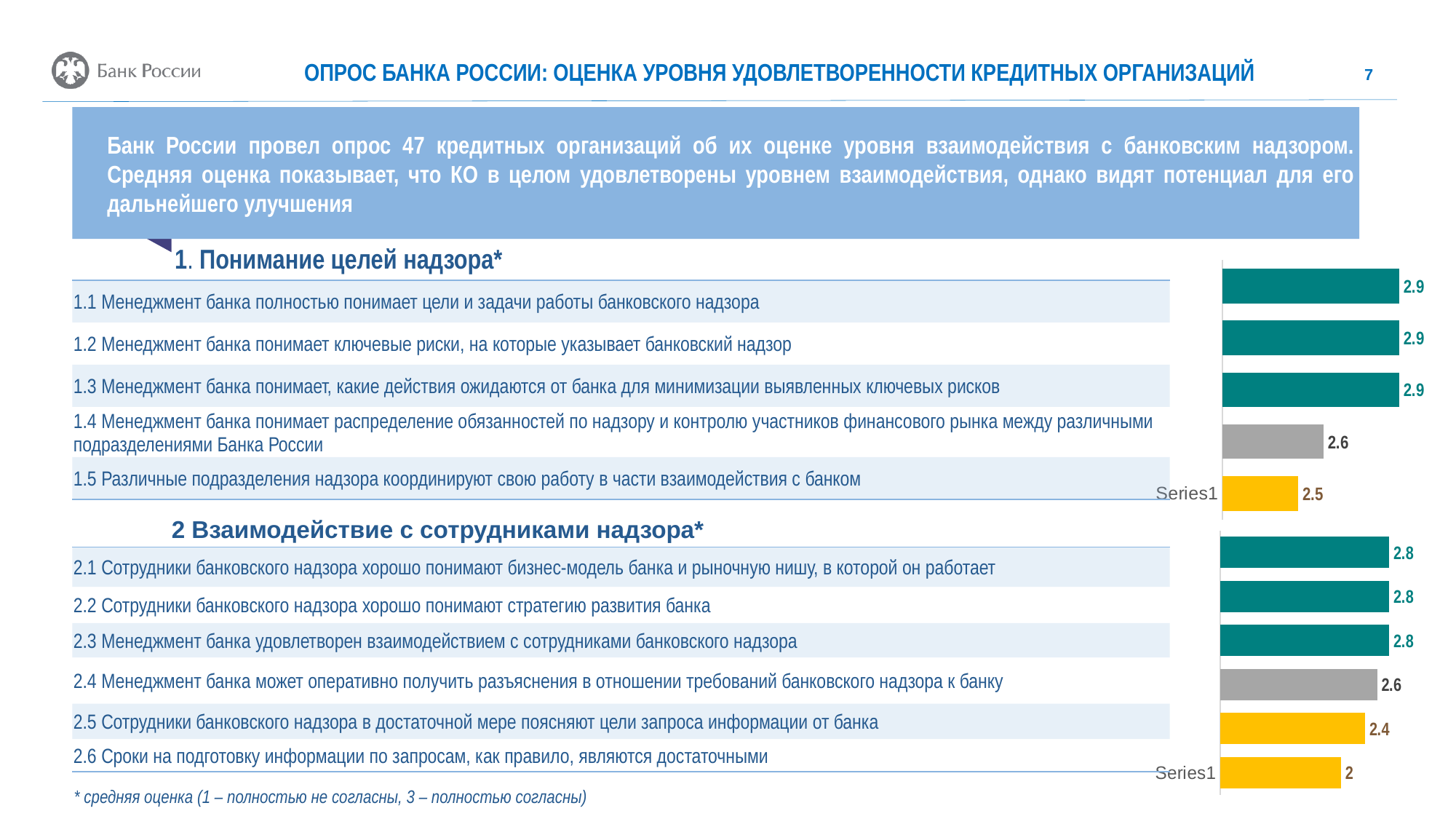
In the chart for section 1 'Понимание целей надзора', what is the value for item 1.4 (Менеджмент банка понимает распределение обязанностей по надзору...)? 2.6 In the chart for section 2 'Взаимодействие с сотрудниками надзора', what is the value for item 2.5 (Сотрудники банковского надзора в достаточной мере поясняют цели запроса информации...)? 2.4 In the chart for section 1 'Понимание целей надзора', which item has the lowest value? 1.5 In the chart for section 1 'Понимание целей надзора', what is the difference between the value for item 1.1 and the value for item 1.5? 0.4 In the chart for section 2 'Взаимодействие с сотрудниками надзора', which is larger: the value for item 2.4 or the value for item 2.5? Item 2.4 (2.6 vs 2.4) What type of chart is used to show the scores on this slide? Bar chart In the chart for section 2 'Взаимодействие с сотрудниками надзора', what is the value for item 2.6 (Сроки на подготовку информации по запросам...)? 2 In the chart for section 2 'Взаимодействие с сотрудниками надзора', which item has the lowest value? 2.6 In the chart for section 2 'Взаимодействие с сотрудниками надзора', what is the difference between the value for item 2.1 and the value for item 2.6? 0.8 In the chart for section 2 'Взаимодействие с сотрудниками надзора', how many bars are plotted? 6 In the chart for section 1 'Понимание целей надзора', how many bars are plotted? 5 In the chart for section 1 'Понимание целей надзора', what is the value for item 1.5 (Различные подразделения надзора координируют свою работу...)? 2.5